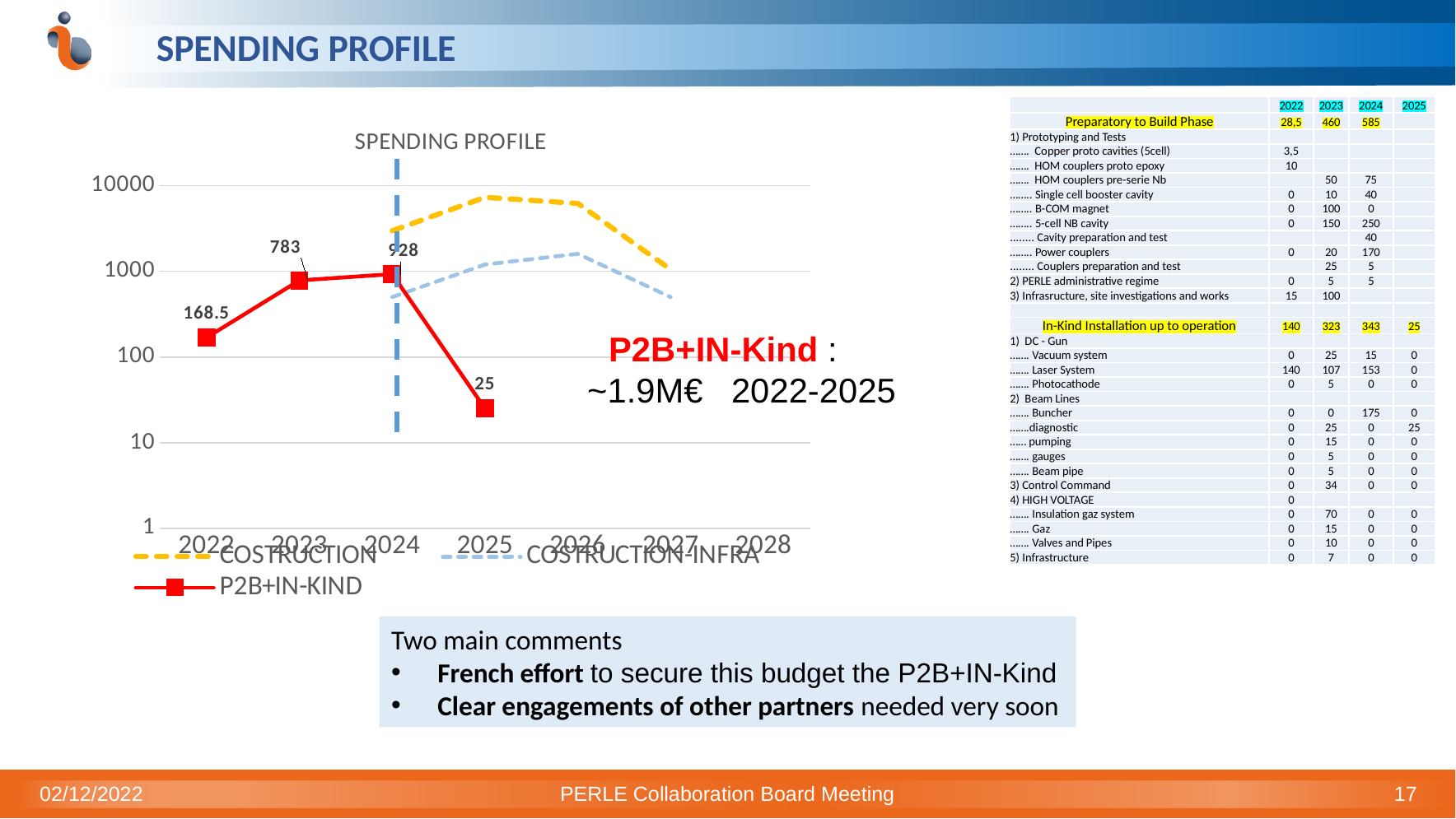
What is the value of the P2B+IN-KIND series in 2025? 25 How many series does the chart legend list? 3 What is the value of the P2B+IN-KIND series in 2023? 783 What is the value of the P2B+IN-KIND series in 2024? 928 Which year has the larger P2B+IN-KIND value, 2023 or 2024? 2024 Is the value of the COSTRUCTION series in 2026 greater or less than 1000? greater What is the value of the P2B+IN-KIND series in 2022? 168.5 What is the difference between the P2B+IN-KIND values for 2024 and 2023? 145 In which year does the P2B+IN-KIND series reach its highest value? 2024 What kind of chart is shown on the slide? line chart Is the value of the COSTRUCTION-INFRA series in 2024 greater or less than 1000? less In which year does the P2B+IN-KIND series have its lowest labelled value? 2025